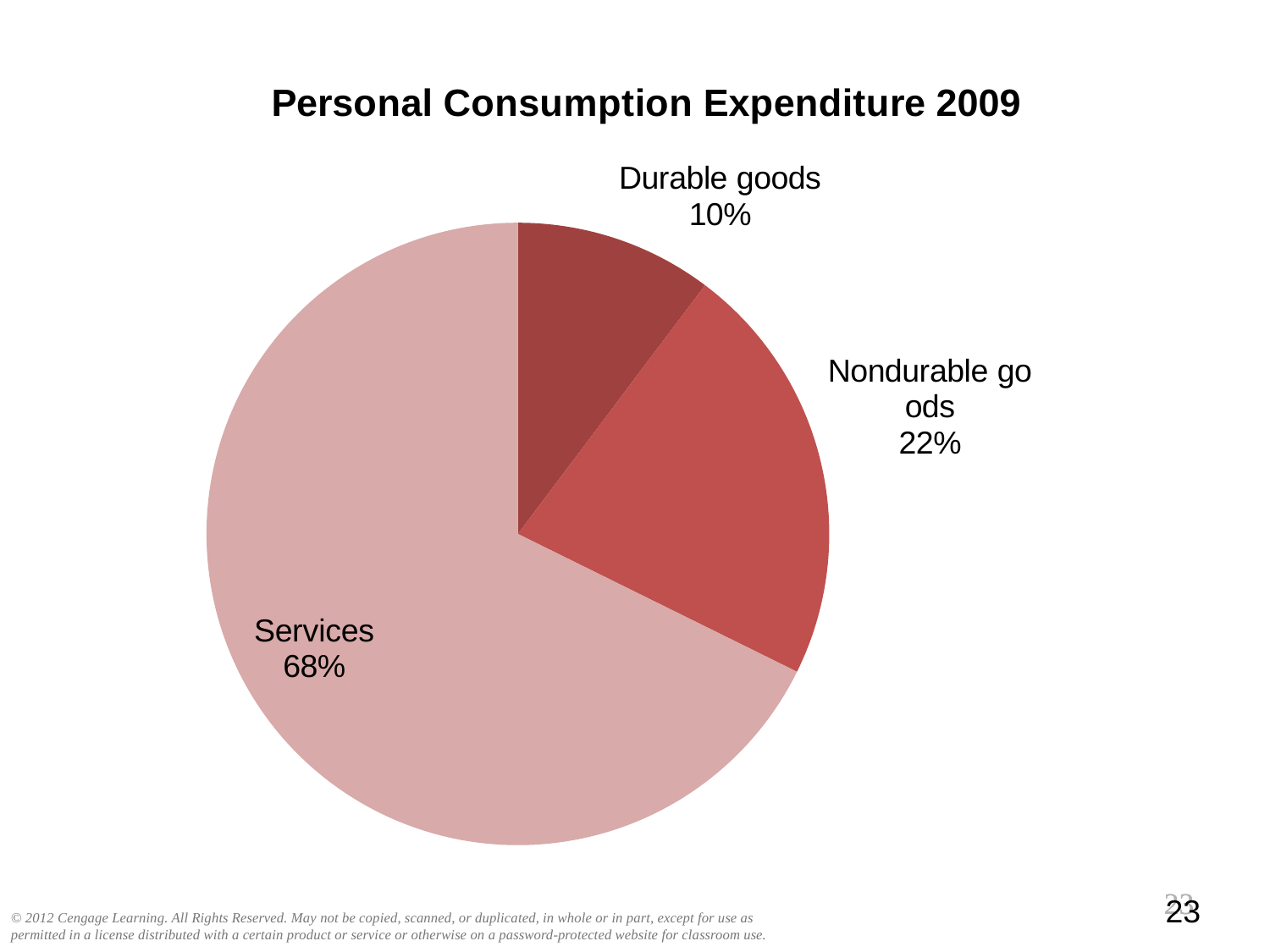
How many percentage points larger is the Services share than the Nondurable goods share? 46 What is the title of the chart? Personal Consumption Expenditure 2009 What kind of chart is shown on the slide? Pie chart What share of Personal Consumption Expenditure 2009 is Services? 68% How many percentage points larger is the Nondurable goods share than the Durable goods share? 12 Which category has the largest slice of the pie? Services Which is larger, the share for Nondurable goods or the share for Durable goods? Nondurable goods What is the combined share of Durable goods and Nondurable goods? 32% What share of Personal Consumption Expenditure 2009 is Durable goods? 10% How many categories are shown in the pie chart? 3 Which category has the smallest slice of the pie? Durable goods What share of Personal Consumption Expenditure 2009 is Nondurable goods? 22%